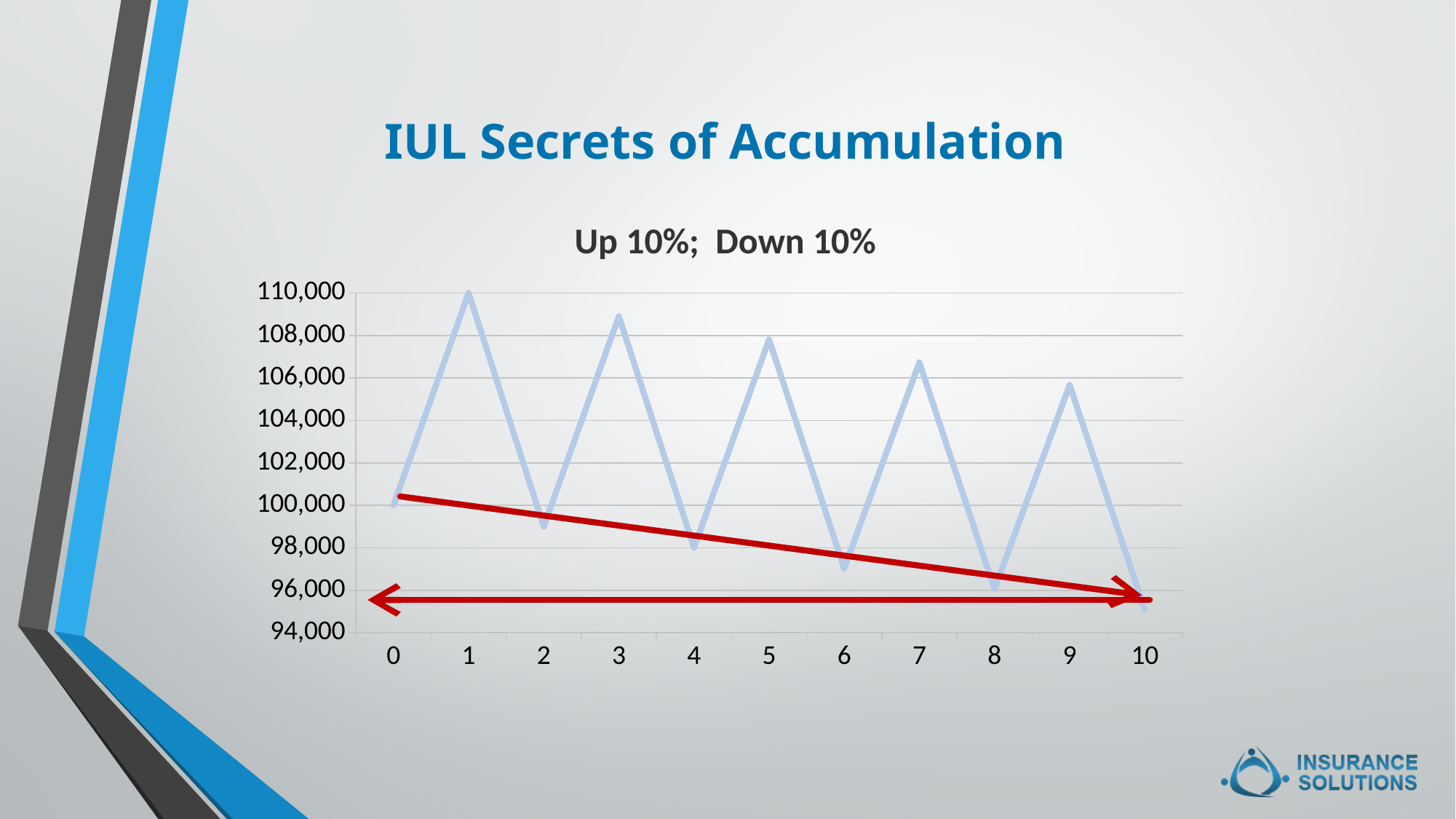
What is the value at x = 1? 110,000 At which x value does the line reach its highest point? 1 Is the value at x = 3 greater or less than 108,000? greater Which is larger, the value at x = 1 or the value at x = 9? x = 1 What kind of chart is shown on the slide? line chart Is the value at x = 10 greater or less than 96,000? less What is the value at x = 0? 100,000 Do the peaks of the line rise or fall as x increases from 1 to 9? fall How many data points are plotted on the line? 11 Is the value at x = 6 greater or less than 98,000? less At which x value does the line reach its lowest point? 10 What is the title of the chart? Up 10%; Down 10%